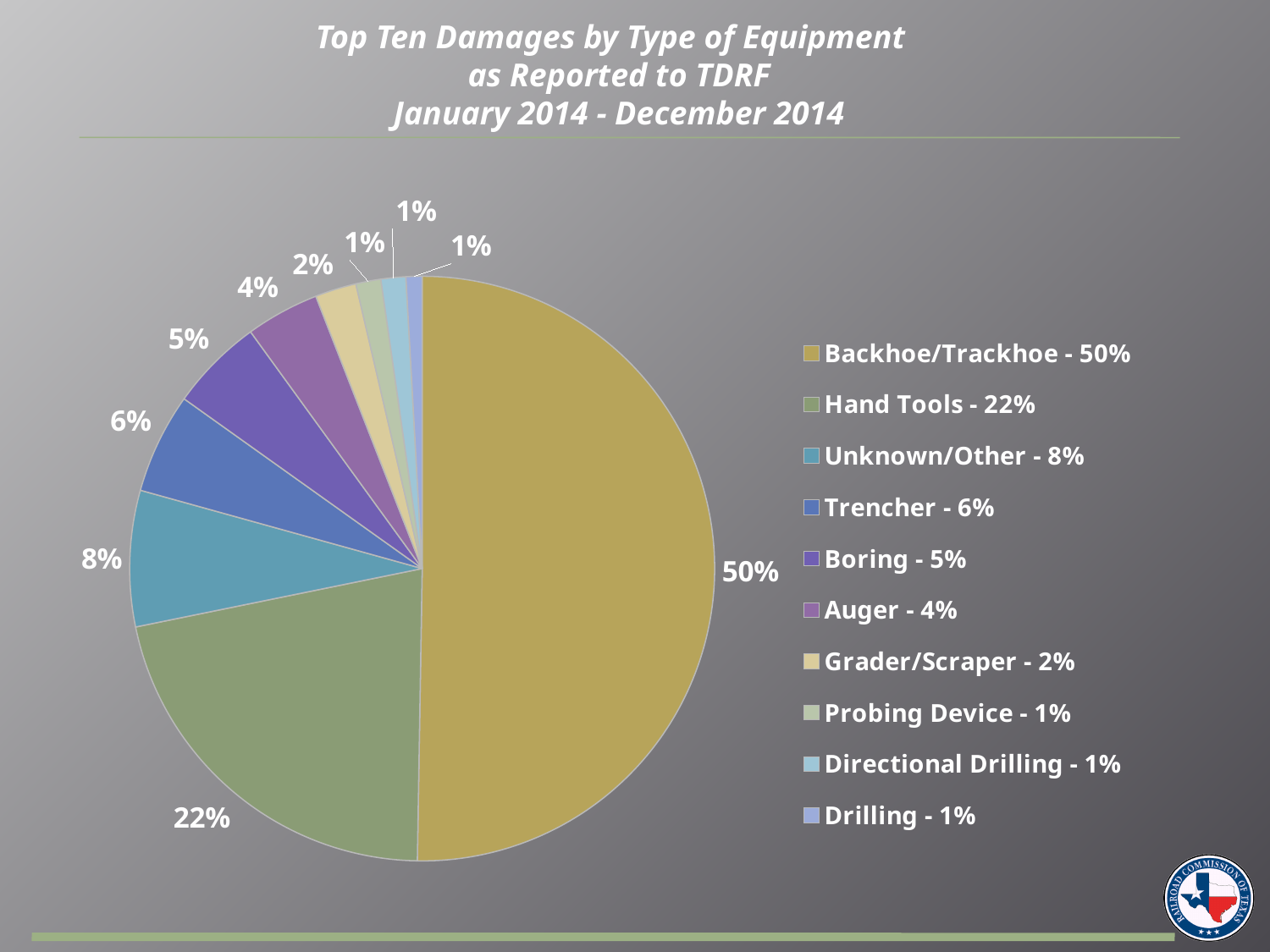
Which has a larger share of damages, Unknown/Other or Boring? Unknown/Other What is the difference between the Backhoe/Trackhoe share and the Hand Tools share? 28% What share of damages is attributed to Auger? 4% What type of chart is shown on the slide? pie chart What share of damages is attributed to Grader/Scraper? 2% What time period does the chart title say the data covers? January 2014 - December 2014 What share of damages is attributed to Trencher? 6% How many slices does the pie chart have? 10 What is the combined share of Trencher and Boring? 11% What share of damages is attributed to Hand Tools? 22% Which type of equipment accounts for the largest share of damages? Backhoe/Trackhoe What share of damages is attributed to Backhoe/Trackhoe? 50%